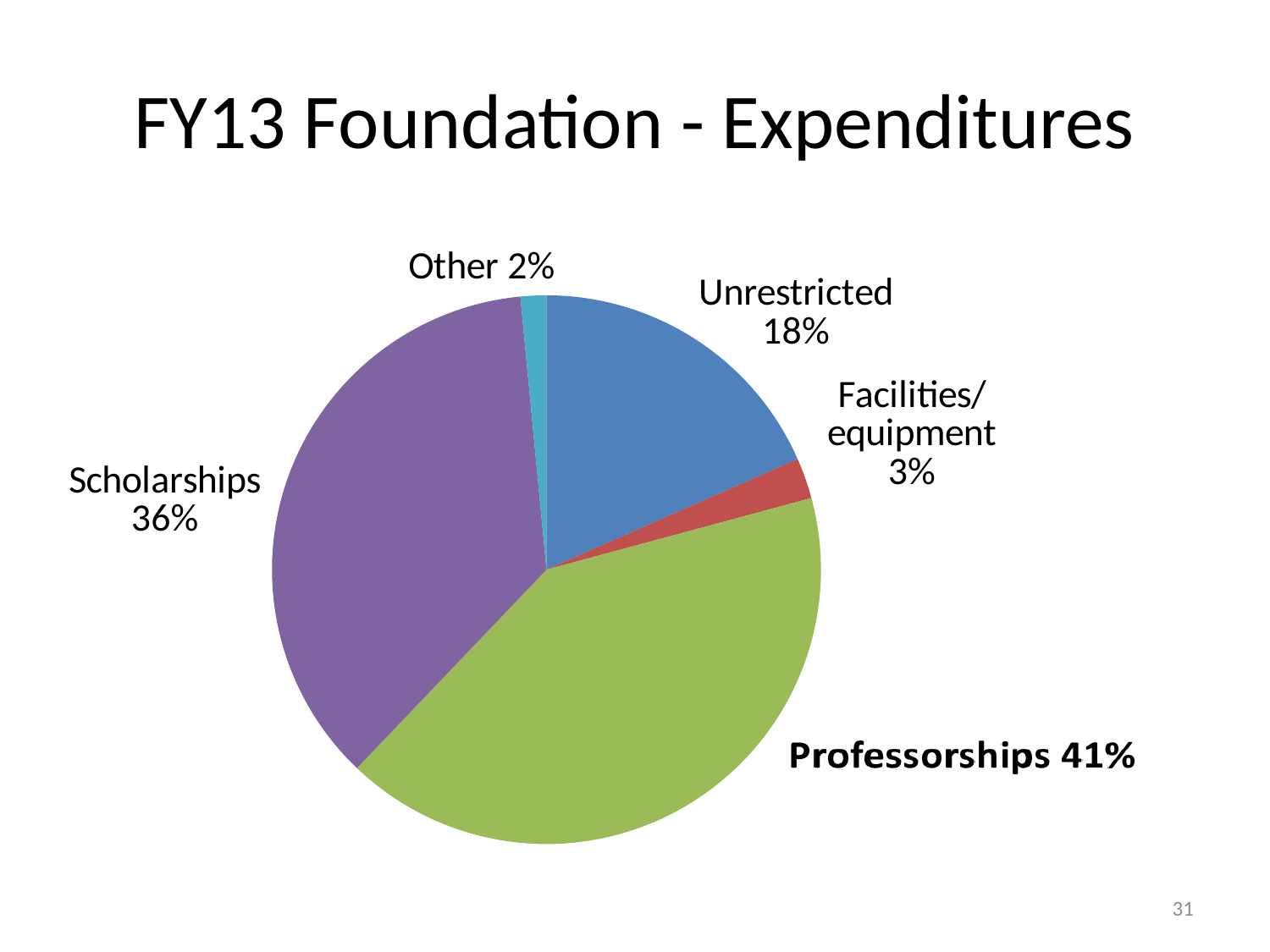
What percentage of expenditures is labelled Other? 2% What kind of chart is shown on the slide? pie chart Which category has the smallest share of expenditures? Other What percentage of expenditures went to Facilities/equipment? 3% What share of expenditures went to Scholarships? 36% Which is larger, the share for Unrestricted or the share for Facilities/equipment? Unrestricted What is the difference in percentage points between Professorships and Scholarships? 5 How many categories are shown in the pie chart? 5 Which category has the largest share of expenditures? Professorships What percentage of expenditures is Unrestricted? 18% What is the title of the chart on the slide? FY13 Foundation - Expenditures What share of FY13 Foundation expenditures went to Professorships? 41%